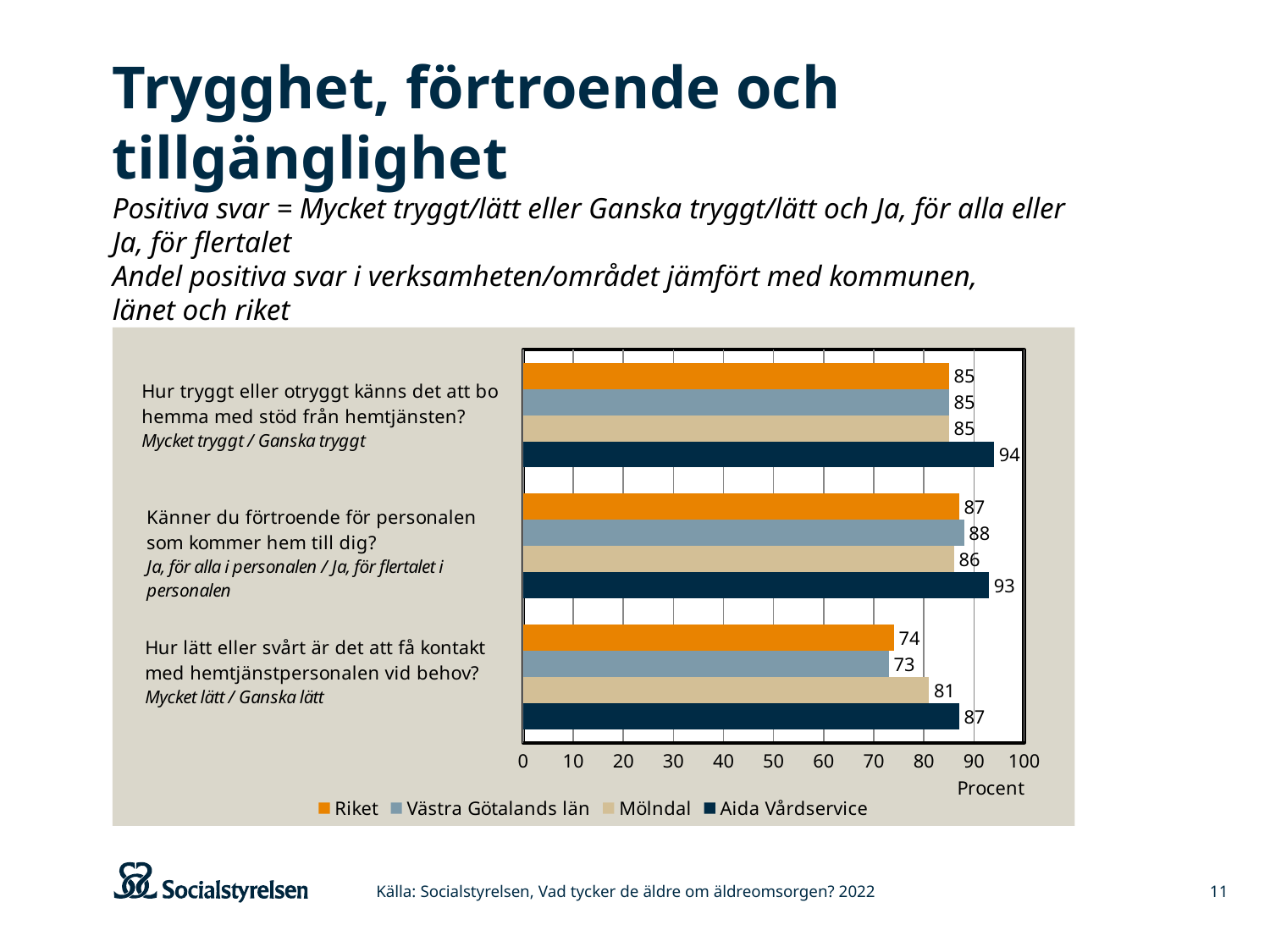
What is the label on the horizontal axis of the chart? Procent Which is larger on the question "Känner du förtroende för personalen som kommer hem till dig?": Riket or Mölndal? Riket How many series does the legend list? 4 What is the value for Västra Götalands län on the question "Känner du förtroende för personalen som kommer hem till dig?"? 88 What is the value for Aida Vårdservice on the question "Hur tryggt eller otryggt känns det att bo hemma med stöd från hemtjänsten?"? 94 Which series has the lowest value on the question "Hur lätt eller svårt är det att få kontakt med hemtjänstpersonalen vid behov?"? Västra Götalands län What kind of chart is shown on the slide? bar chart What is the difference between Aida Vårdservice and Riket on the question "Hur lätt eller svårt är det att få kontakt med hemtjänstpersonalen vid behov?"? 13 What is the value for Mölndal on the question "Hur lätt eller svårt är det att få kontakt med hemtjänstpersonalen vid behov?"? 81 How many questions (categories) are plotted on the chart? 3 Is the value for Riket on the question "Hur lätt eller svårt är det att få kontakt med hemtjänstpersonalen vid behov?" greater or less than 80? less Which series has the highest value on the question "Känner du förtroende för personalen som kommer hem till dig?"? Aida Vårdservice